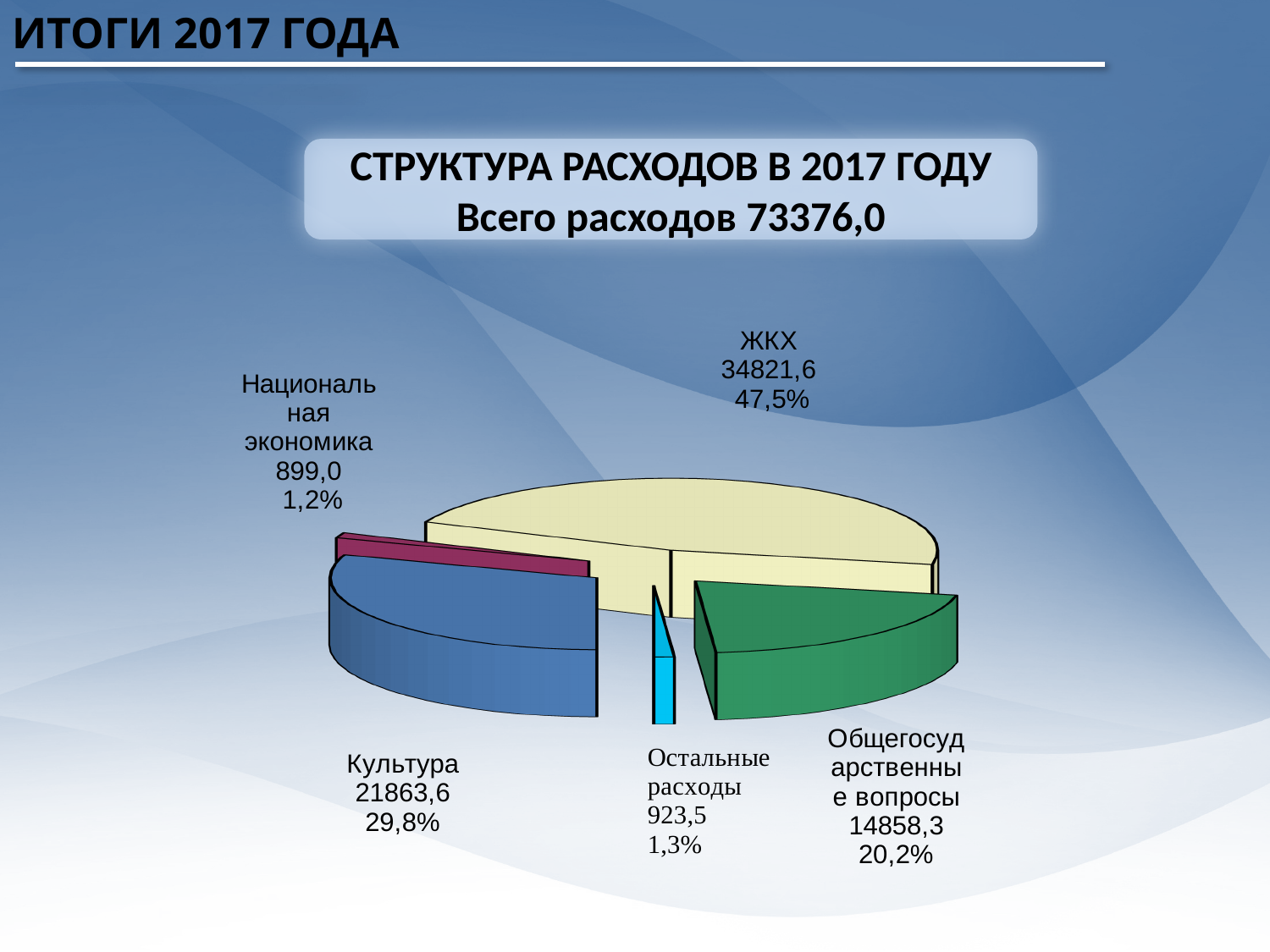
Which is larger, the value for Остальные расходы or the value for Национальная экономика? Остальные расходы How many categories does the pie chart show? 5 What is the value for Культура? 21863,6 What is the value for Общегосударственные вопросы? 14858,3 What total expenditure is stated in the chart title? 73376,0 Which category has the smallest slice? Национальная экономика What type of chart is shown on the slide? pie chart What is the value for ЖКХ? 34821,6 What share of the pie does Национальная экономика represent? 1,2% What share of the pie does ЖКХ represent? 47,5% Which category has the largest slice? ЖКХ What is the difference between the values for ЖКХ and Культура? 12958,0